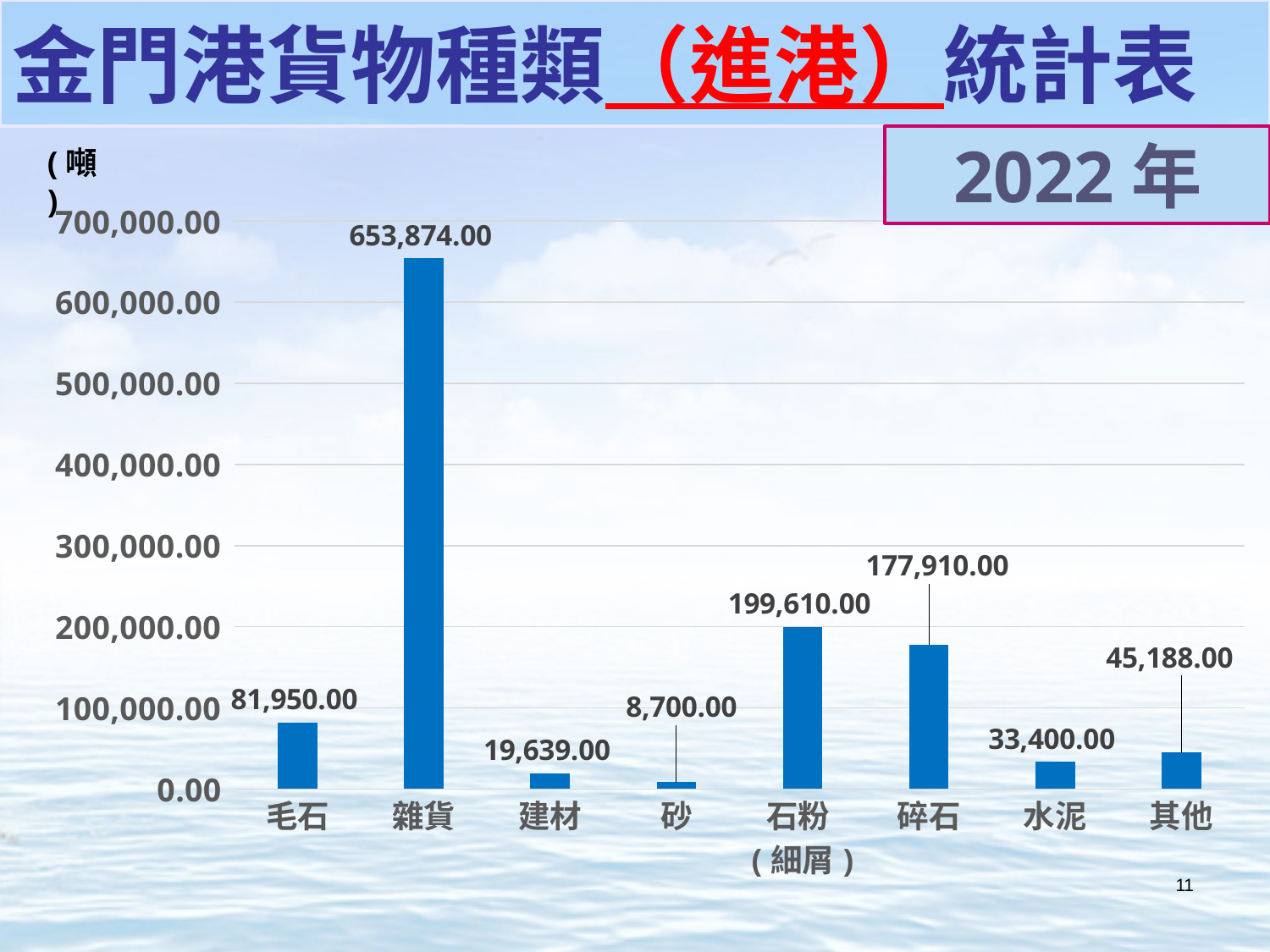
Which is larger, the value for 毛石 or the value for 其他? 毛石 What is the difference between the values for 其他 and 水泥? 11,788.00 Is the value for 碎石 greater or less than 200,000.00? less What is the value for 雜貨? 653,874.00 How many categories are shown on the x axis? 8 What is the value for 石粉（細屑）? 199,610.00 What is the value for 水泥? 33,400.00 What is the value for 砂? 8,700.00 Which category has the highest value? 雜貨 Which category has the lowest value? 砂 What kind of chart is shown on the slide? bar chart What is the difference between the values for 石粉（細屑） and 碎石? 21,700.00